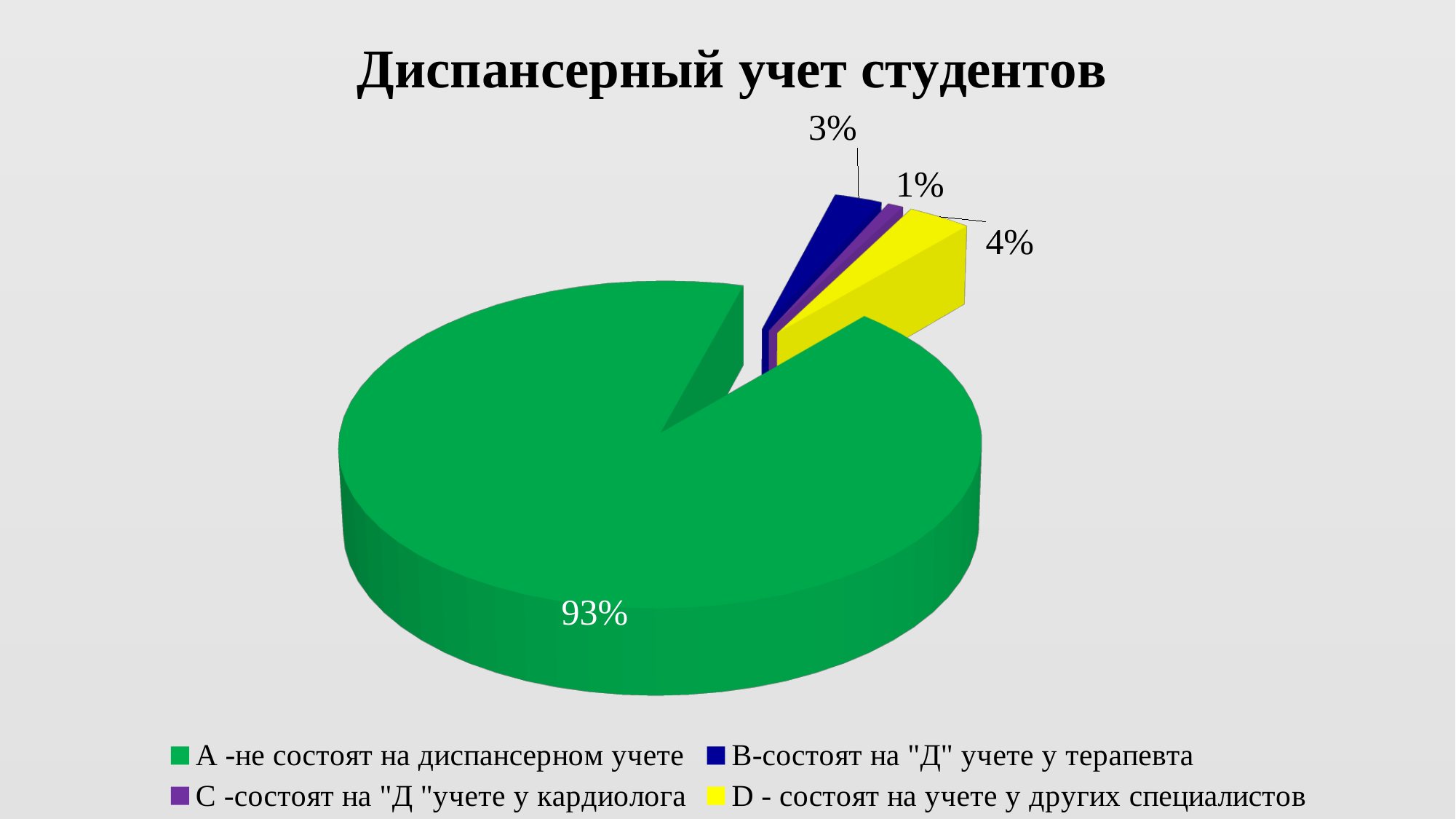
What type of chart is shown on the slide? Pie chart What percentage of students are in category A (не состоят на диспансерном учете)? 93% Which is larger: the share for category B (терапевт) or category D (другие специалисты)? D - состоят на учете у других специалистов What percentage of students are in category C (состоят на "Д" учете у кардиолога)? 1% Which category has the smallest share of the pie? C -состоят на "Д "учете у кардиолога What is the difference in percentage points between category A and category D? 89 What is the title of the chart? Диспансерный учет студентов Which category has the largest share of the pie? A -не состоят на диспансерном учете What percentage of students are in category B (состоят на "Д" учете у терапевта)? 3% What percentage of students are in category D (состоят на учете у других специалистов)? 4% What colour is the slice for category D (состоят на учете у других специалистов)? Yellow How many slices does the pie chart have? 4